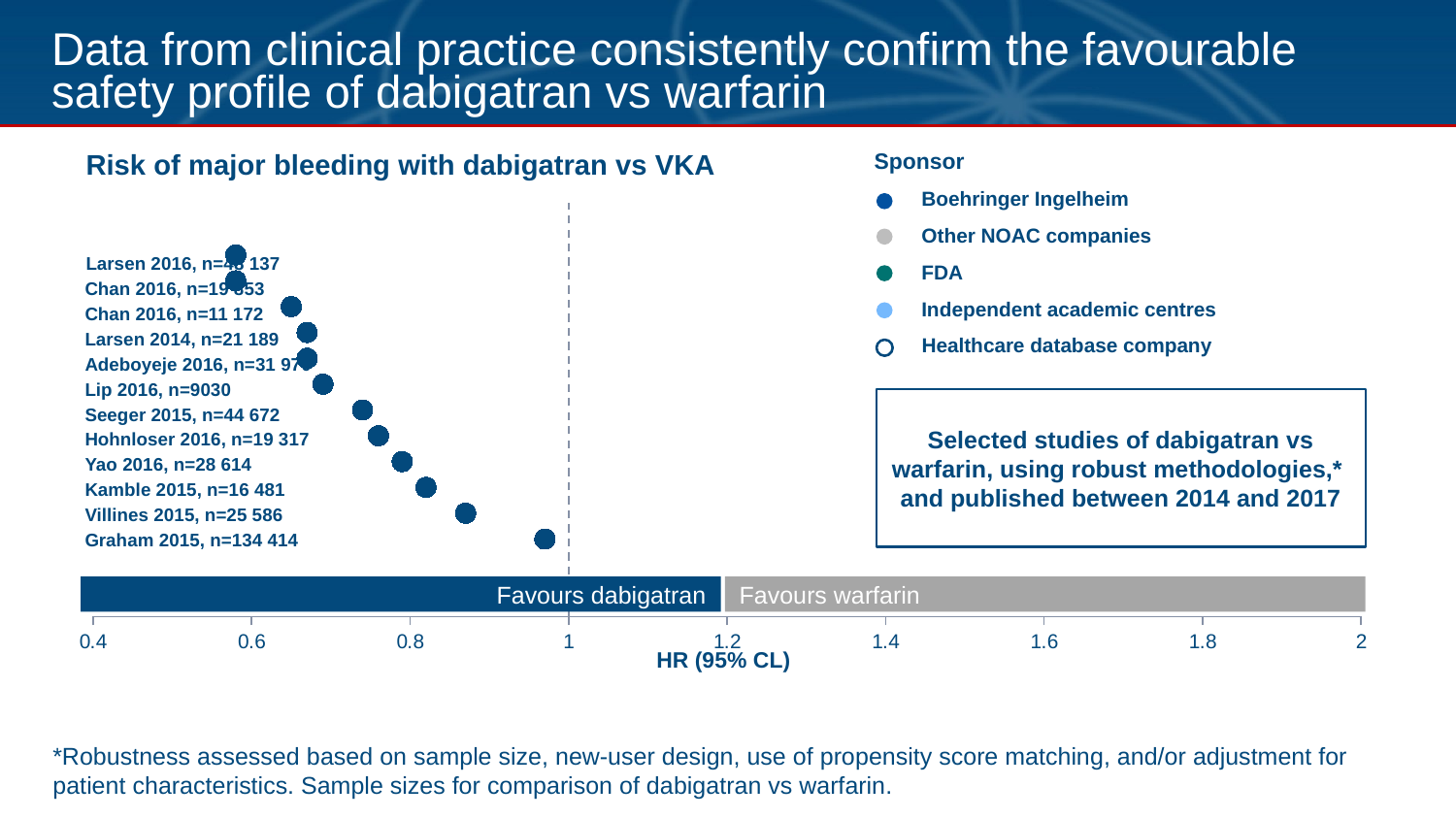
Is the hazard ratio for Villines 2015 greater or less than 0.8? greater Do the hazard ratios increase or decrease going down the list of studies from Larsen 2016 to Graham 2015? increase How many sponsor categories does the legend list? 5 Is the hazard ratio for Seeger 2015 greater or less than 0.8? less How many studies are plotted in the chart? 12 What is the label of the x axis? HR (95% CL) Which study has the highest hazard ratio in the chart? Graham 2015, n=134 414 Which has the larger hazard ratio, Kamble 2015 or Lip 2016? Kamble 2015 Is the hazard ratio for Larsen 2016 greater or less than 0.6? less What is the title of the chart? Risk of major bleeding with dabigatran vs VKA What kind of chart is shown on the slide? Scatter (dot) plot